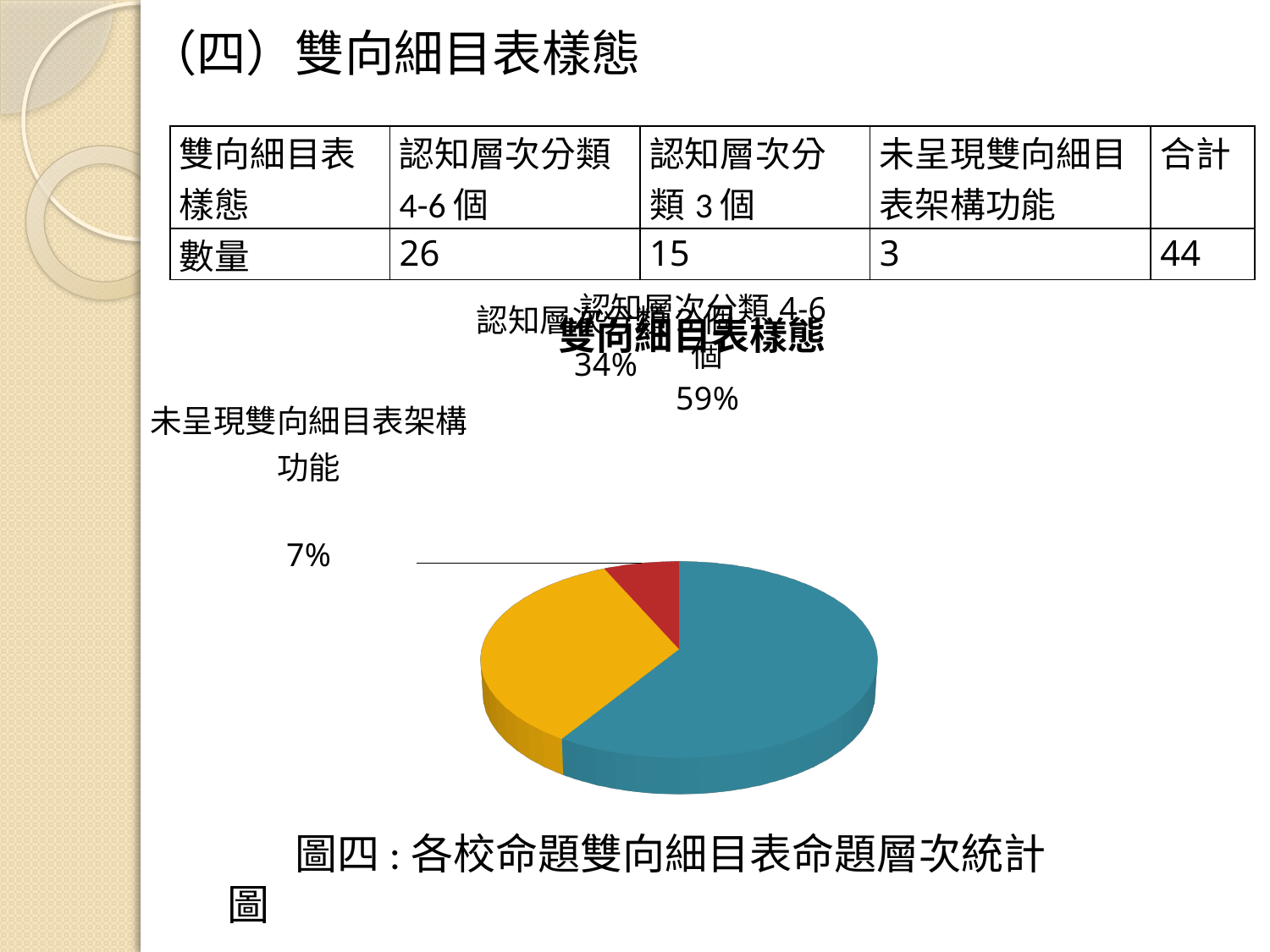
What share of the pie does 認知層次分類 3 個 take? 34% Which category has the smallest slice of the pie? 未呈現雙向細目表架構功能 What share of the pie does 認知層次分類 4-6 個 take? 59% What kind of chart is shown on the slide? pie chart By how many percentage points does the share of 認知層次分類 3 個 exceed that of 未呈現雙向細目表架構功能? 27% Which category has the largest slice of the pie? 認知層次分類 4-6 個 What share of the pie does 未呈現雙向細目表架構功能 take? 7% How many slices does the pie chart have? 3 By how many percentage points does the share of 認知層次分類 4-6 個 exceed that of 認知層次分類 3 個? 25% What is the title of the pie chart? 雙向細目表樣態 Which is larger in the pie chart: 認知層次分類 3 個 or 未呈現雙向細目表架構功能? 認知層次分類 3 個 What colour is the largest slice of the pie chart? teal blue